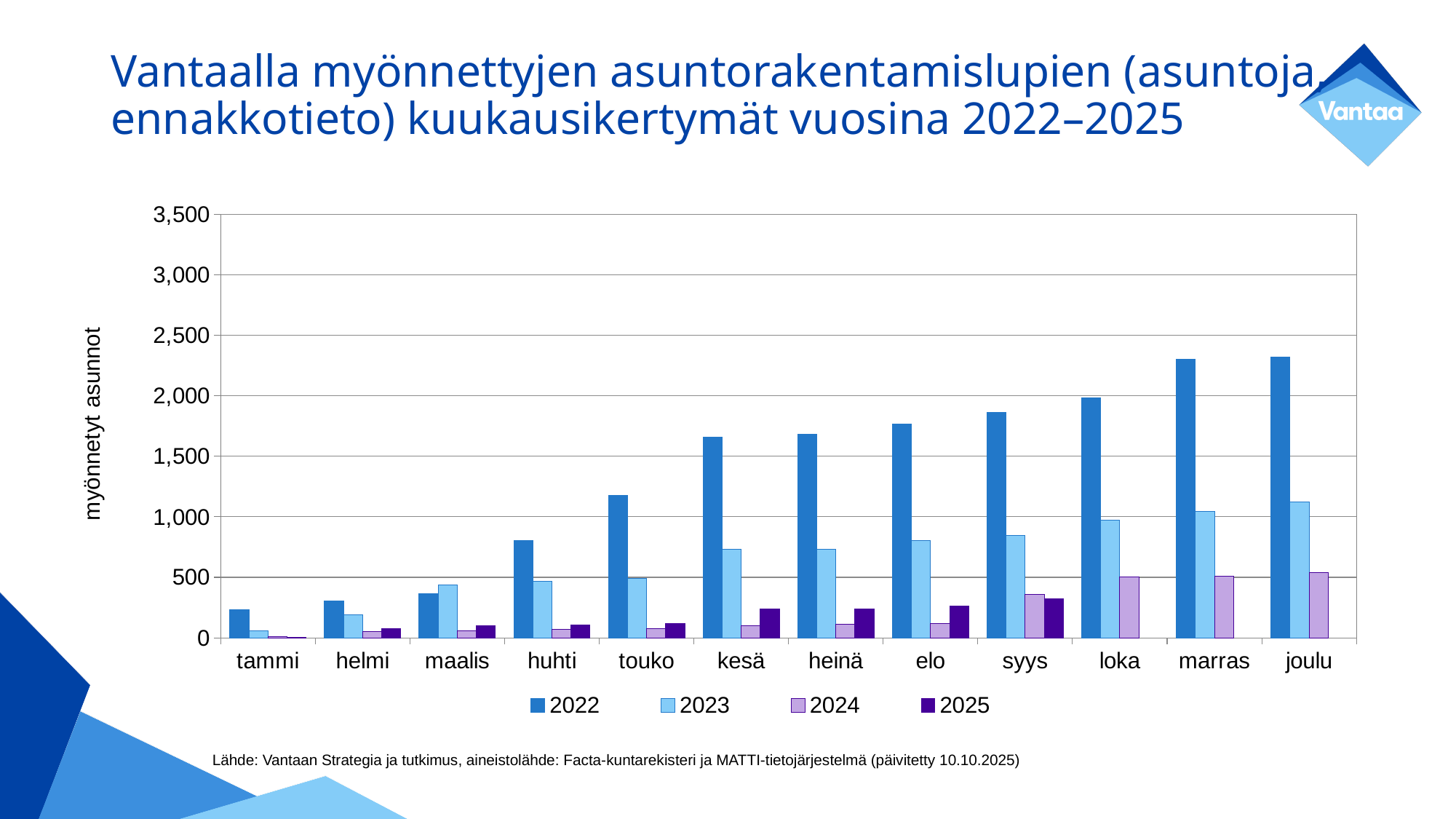
What kind of chart is shown on the slide? bar chart Is the value for 2023 in joulu greater or less than 1,000? greater Is the value for 2022 in joulu greater or less than 2,000? greater Do the values for the 2022 series rise or fall from tammi to joulu? rise How many months are shown on the x axis? 12 How many series does the legend list? 4 Is the value for 2022 in huhti greater or less than 1,000? less Which month has the highest value for the 2025 series? syys Which month has the highest value for the 2023 series? joulu Which month has the lowest value for the 2022 series? tammi In joulu, which series has the larger value, 2022 or 2023? 2022